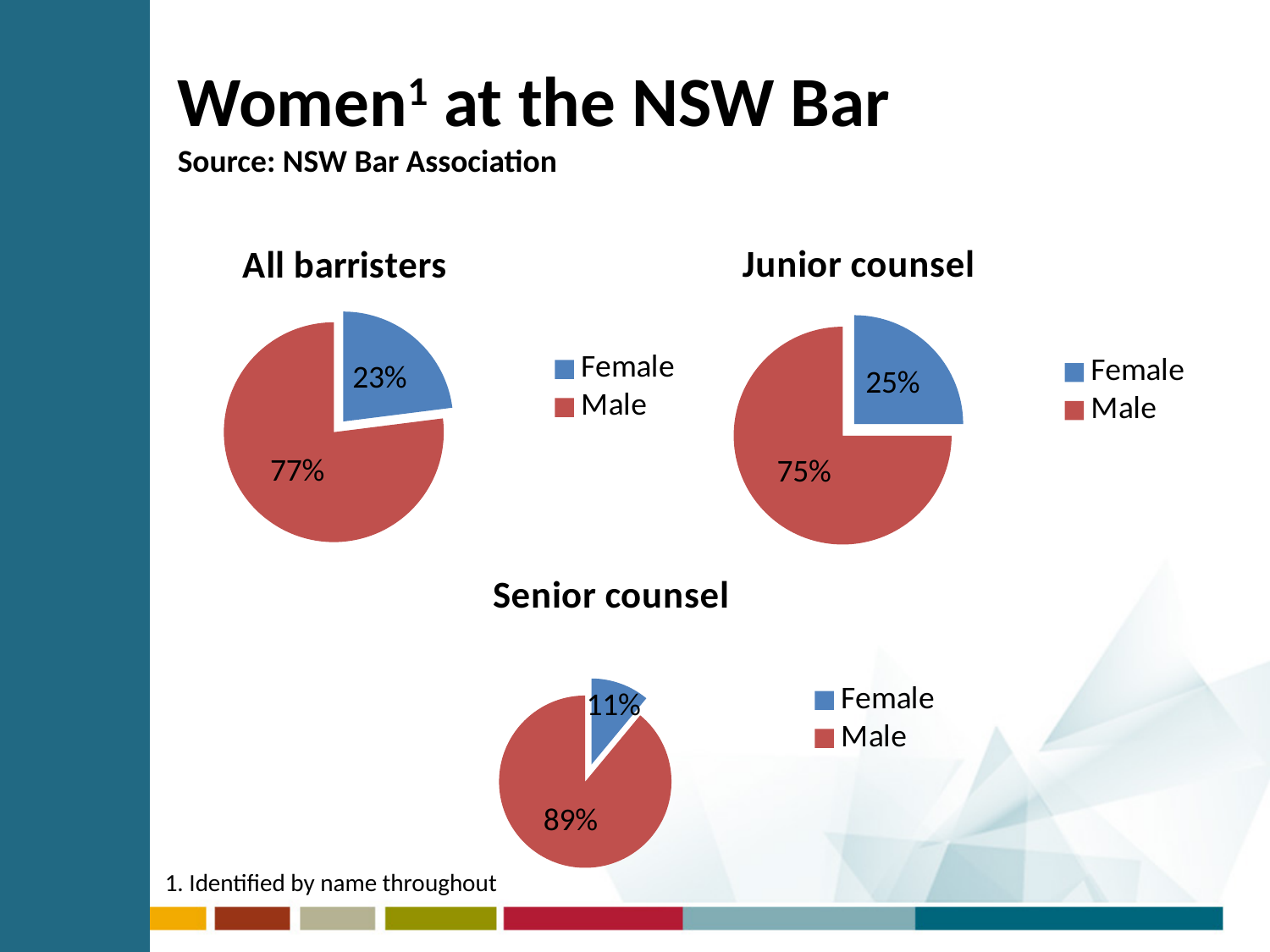
In the 'Senior counsel' chart, what is the difference between the Male and Female percentages? 78% In the 'All barristers' chart, what percentage is Male? 77% What kind of chart is the 'Junior counsel' chart? Pie chart In the 'Senior counsel' chart, what share of the pie is Female? 11% How many slices does the 'Senior counsel' pie chart have? 2 In the 'All barristers' chart, what percentage is Female? 23% How many entries does the legend of the 'All barristers' chart list? 2 In the 'Junior counsel' chart, what percentage is Female? 25% In the 'All barristers' chart, what is the difference between the Male and Female percentages? 54% In the 'Senior counsel' chart, what percentage is Male? 89% In the 'Junior counsel' chart, what colour is the Female slice? Blue In the 'Junior counsel' chart, which slice is larger, Female or Male? Male